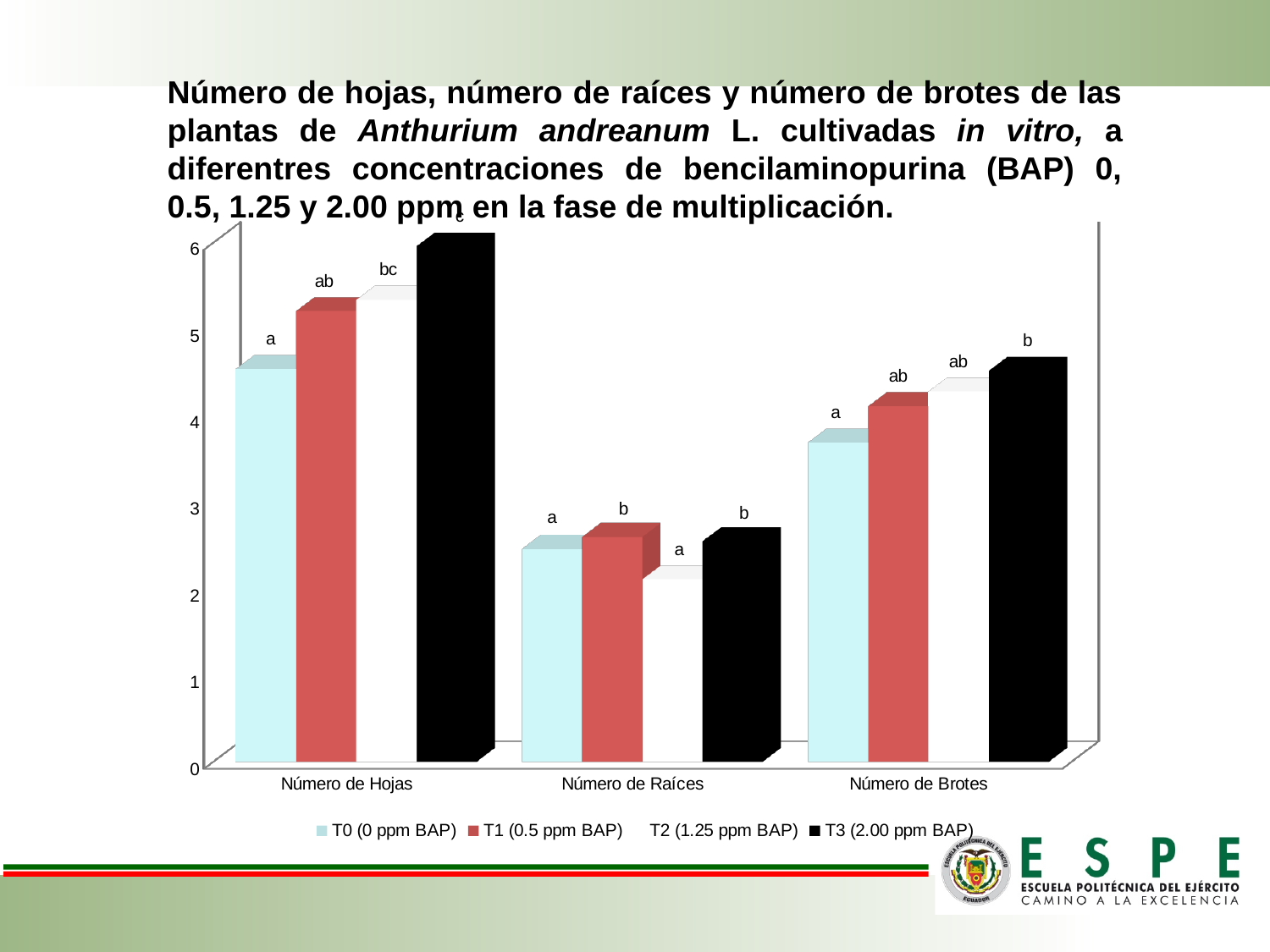
Which category has the lowest bars overall? Número de Raíces What letter label appears above the T3 (2.00 ppm BAP) bar in the Número de Hojas category? c Which series has the lowest bar in the Número de Hojas category? T0 (0 ppm BAP) Which legend entry corresponds to the black bars? T3 (2.00 ppm BAP) What kind of chart is shown on the slide? bar chart Is the value for T2 (1.25 ppm BAP) in Número de Raíces greater or less than 3? less Which is larger: the T3 (2.00 ppm BAP) bar for Número de Hojas or the T3 (2.00 ppm BAP) bar for Número de Raíces? Número de Hojas Is the value for T3 (2.00 ppm BAP) in Número de Brotes greater or less than 4? greater Which series has the highest bar in the Número de Hojas category? T3 (2.00 ppm BAP) Is the value for T0 (0 ppm BAP) in Número de Hojas greater or less than 4? greater How many series does the legend list? 4 How many categories are shown on the x axis of the chart? 3